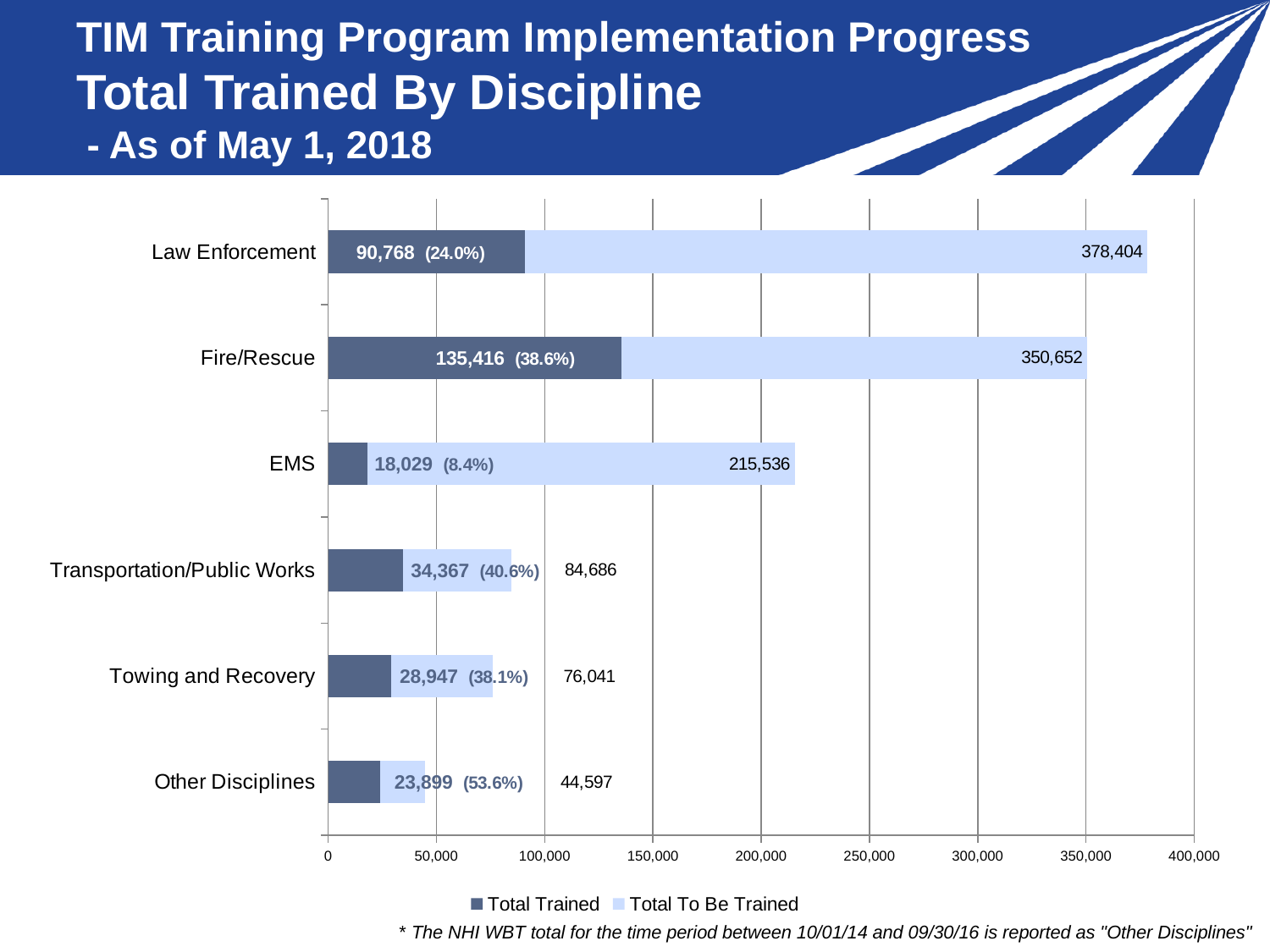
Which discipline has the highest Total Trained value? Fire/Rescue Is the Total To Be Trained value for Law Enforcement greater or less than 350,000? greater How many disciplines are shown on the chart? 6 What percentage is shown next to the Total Trained value for Other Disciplines? 53.6% What is the difference between the Total To Be Trained value (378,404) and the Total Trained value (90,768) for Law Enforcement? 287,636 What value is labelled on the Total To Be Trained bar for EMS? 215,536 Which has a larger Total Trained value, Transportation/Public Works or Towing and Recovery? Transportation/Public Works What are the two entries listed in the legend? Total Trained and Total To Be Trained How many series does the legend list? 2 Which discipline has the lowest Total Trained value? EMS What is the Total Trained value for Fire/Rescue? 135,416 What kind of chart is shown on the slide? Bar chart